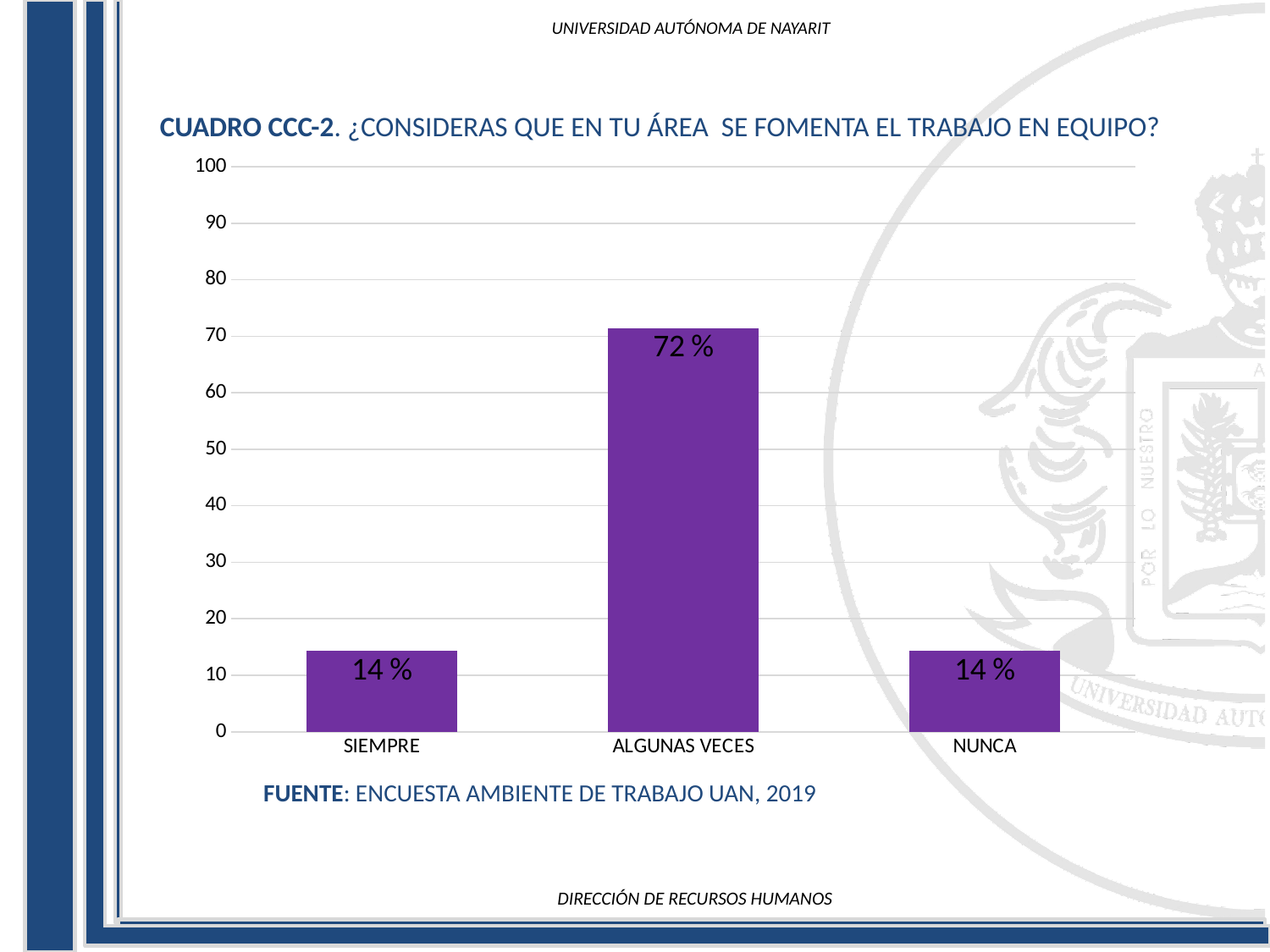
Is the value for ALGUNAS VECES greater or less than 50? greater Which category has the highest value? ALGUNAS VECES How many categories are shown on the x axis? 3 What is the source cited below the chart? ENCUESTA AMBIENTE DE TRABAJO UAN, 2019 What is the value for SIEMPRE? 14 % What is the value for ALGUNAS VECES? 72 % What kind of chart is shown on the slide? bar chart What is the value for NUNCA? 14 % What is the maximum value shown on the y axis? 100 Is the value for SIEMPRE greater or less than 20? less Which is larger, the value for ALGUNAS VECES or the value for NUNCA? ALGUNAS VECES What is the difference between the values for ALGUNAS VECES and SIEMPRE? 58 %